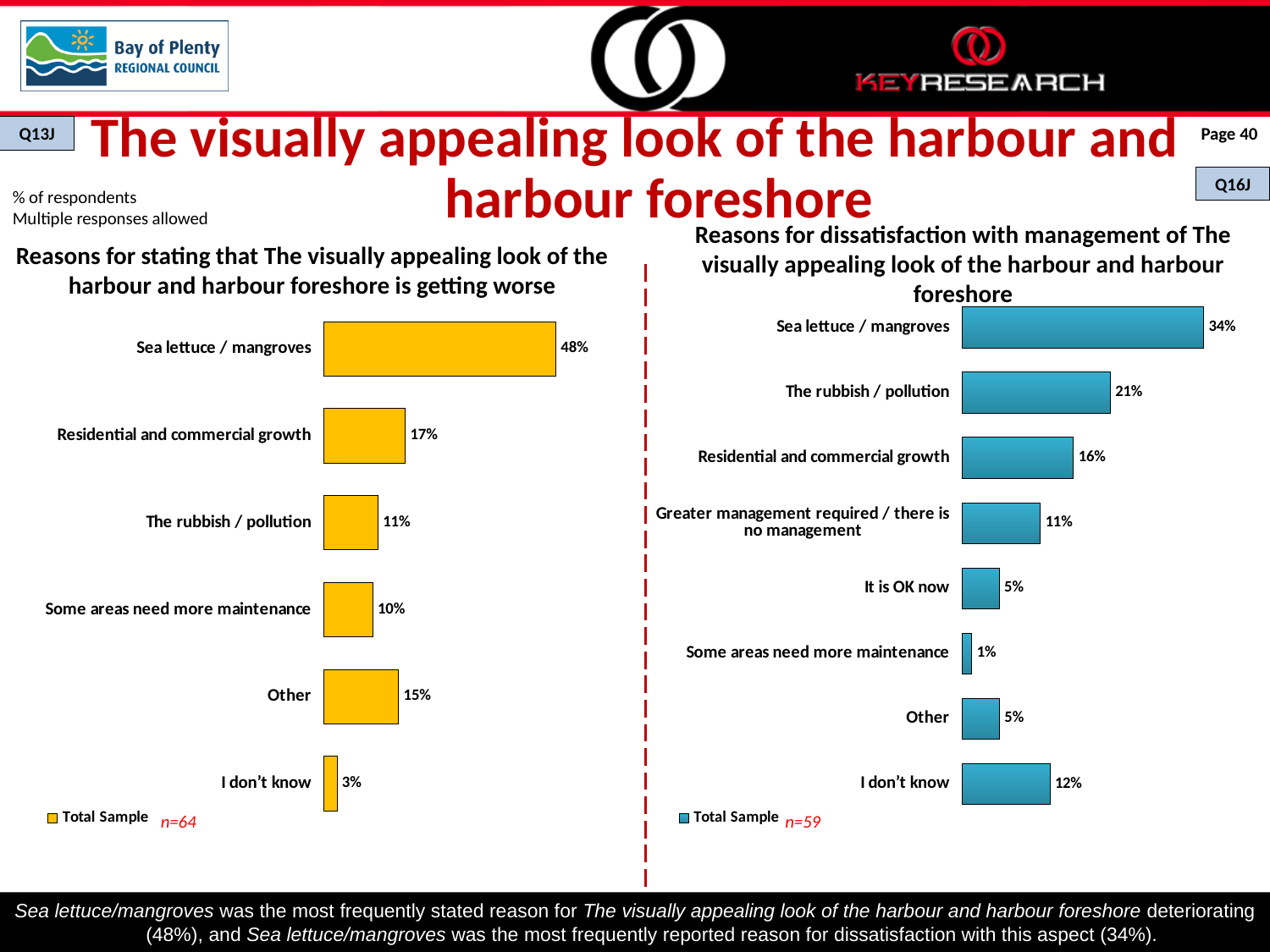
What type of chart is the left chart (reasons for getting worse)? Bar chart How many categories are shown in the right chart (reasons for dissatisfaction with management)? 8 In the left chart (reasons for getting worse), what is the difference between Sea lettuce / mangroves and Residential and commercial growth? 31% In the left chart (reasons for getting worse), which category has the lowest value? I don’t know In the right chart (reasons for dissatisfaction with management), what is the difference between Sea lettuce / mangroves and I don’t know? 22% In the left chart (reasons for getting worse), which is larger: Other or The rubbish / pollution? Other In the right chart (reasons for dissatisfaction with management), which category has the highest value? Sea lettuce / mangroves In the right chart (reasons for dissatisfaction with management), what percentage is shown for The rubbish / pollution? 21% What is the legend entry shown for the right chart (reasons for dissatisfaction with management)? Total Sample In the left chart (reasons for getting worse), what percentage is shown for Sea lettuce / mangroves? 48% How many categories are shown in the left chart (reasons for getting worse)? 6 In the right chart (reasons for dissatisfaction with management), which category has the lowest value? Some areas need more maintenance